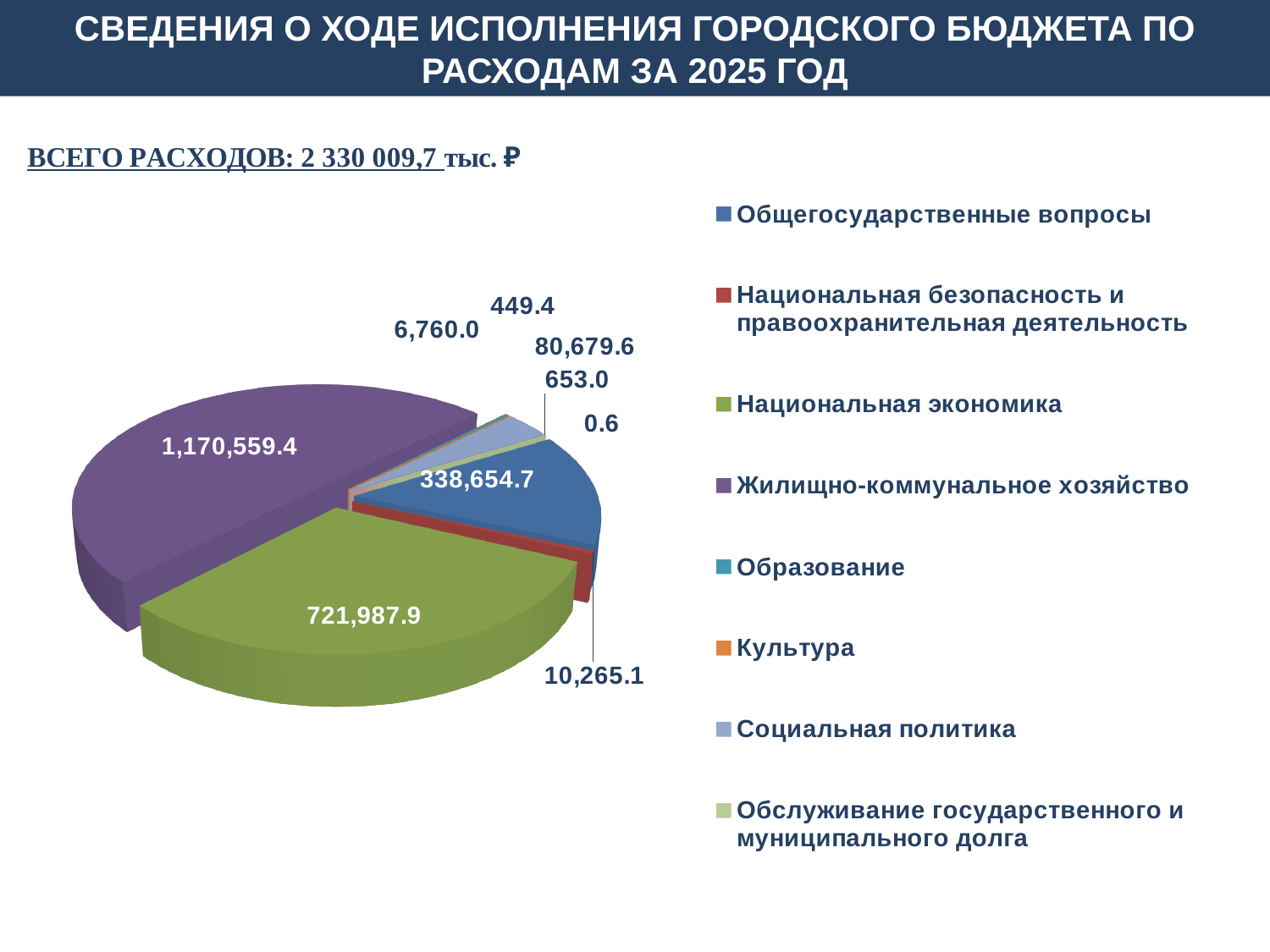
What is the difference between the values for Жилищно-коммунальное хозяйство and Национальная экономика? 448,571.5 What is the value of the largest slice in the pie chart? 1,170,559.4 How many entries does the legend list? 8 What is the value shown for Общегосударственные вопросы? 338,654.7 What is the smallest data label shown on the pie chart? 0.6 How many data labels are shown on the pie chart? 9 What kind of chart is shown on the slide? pie chart What total expenditure amount is stated on the slide? 2 330 009,7 тыс. ₽ Which category has the largest slice in the pie chart? Жилищно-коммунальное хозяйство Which is larger: the value for Национальная экономика or the value for Общегосударственные вопросы? Национальная экономика What is the value shown for Национальная безопасность и правоохранительная деятельность? 10,265.1 What is the value shown for Национальная экономика? 721,987.9